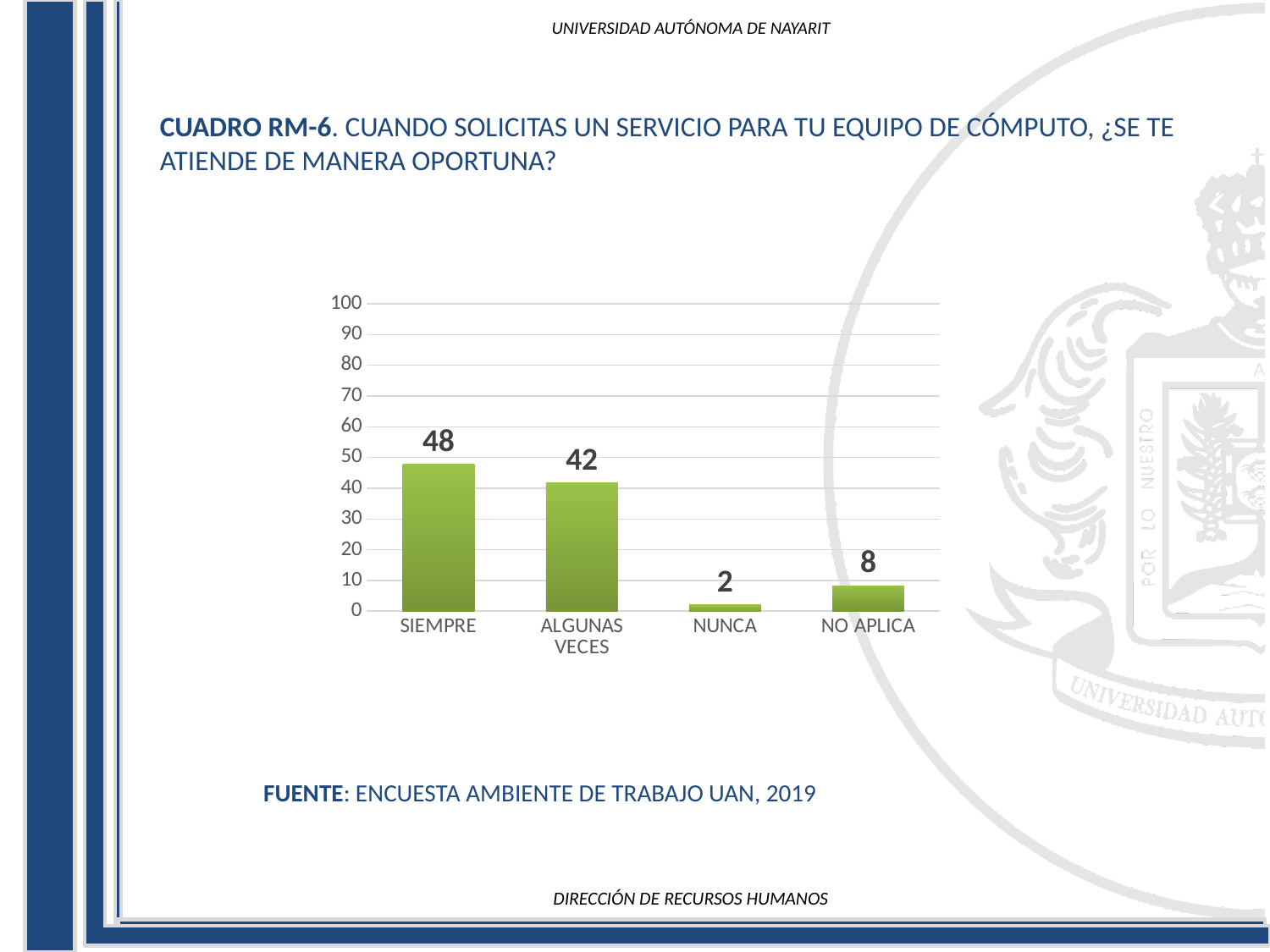
What is the value for NO APLICA? 8 What is the difference between the values for NO APLICA and NUNCA? 6 What kind of chart is shown on the slide? bar chart Is the value for ALGUNAS VECES greater or less than 50? less What is the value for ALGUNAS VECES? 42 What is the value for SIEMPRE? 48 Which is larger, the value for NO APLICA or the value for NUNCA? NO APLICA Which category has the highest value? SIEMPRE What is the value for NUNCA? 2 How many categories are shown on the x axis? 4 Which category has the lowest value? NUNCA What is the difference between the values for SIEMPRE and ALGUNAS VECES? 6